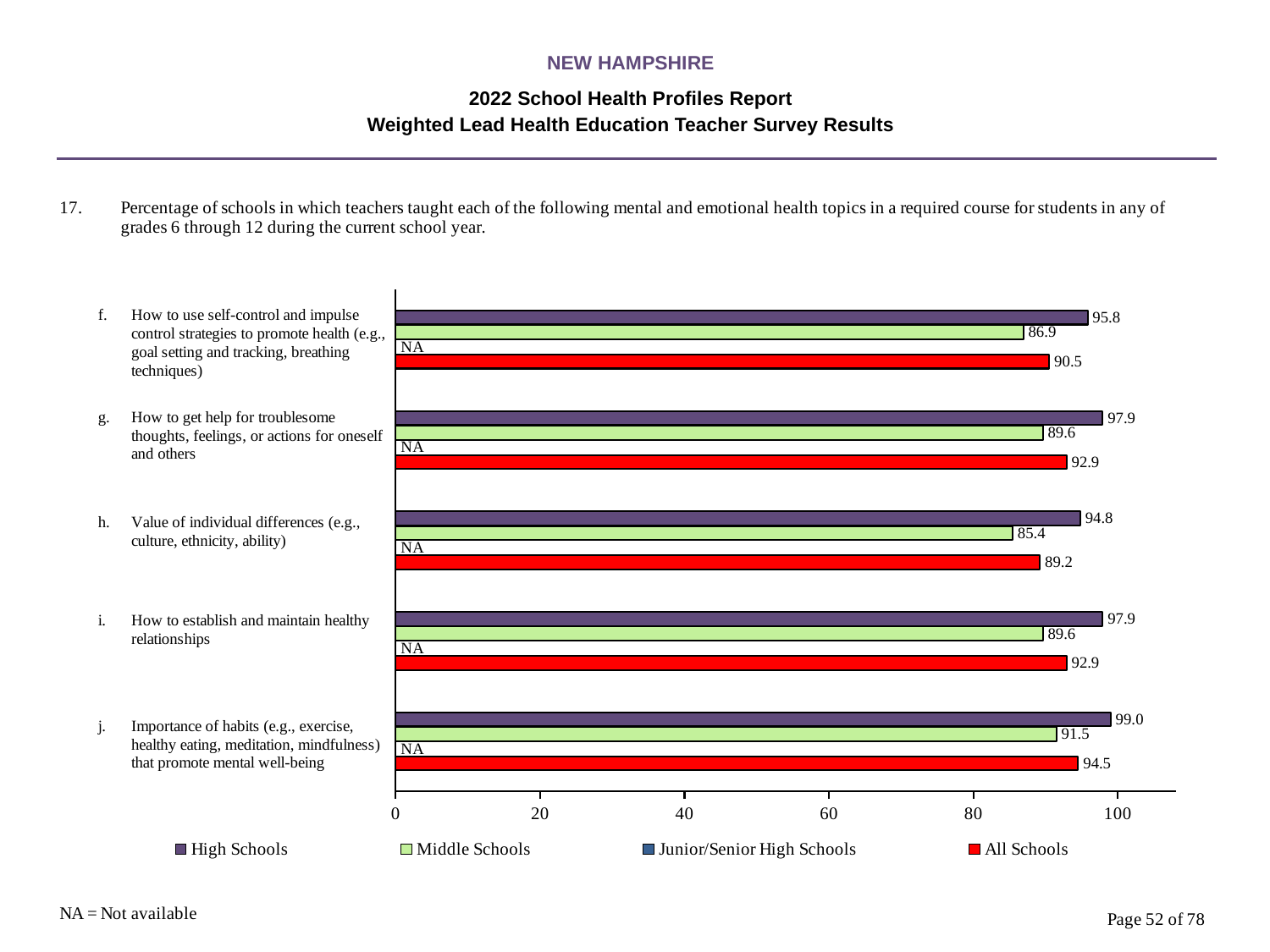
What is the difference between the High Schools and Middle Schools values for topic i, how to establish and maintain healthy relationships? 8.3 What is the Middle Schools value for topic h, value of individual differences? 85.4 What is shown for Junior/Senior High Schools for topic g, how to get help for troublesome thoughts, feelings, or actions? NA What is the High Schools value for topic j, importance of habits that promote mental well-being? 99.0 What is the All Schools value for topic f, how to use self-control and impulse control strategies? 90.5 Which is larger for topic g: the Middle Schools value or the All Schools value? All Schools How many topics are listed on the chart? 5 Is the Middle Schools value for topic f greater or less than 80? greater Which topic has the lowest Middle Schools value? h. Value of individual differences (e.g., culture, ethnicity, ability) Which topic has the highest High Schools value? j. Importance of habits (e.g., exercise, healthy eating, meditation, mindfulness) that promote mental well-being What kind of chart is shown on the slide? bar chart How many series does the legend list? 4